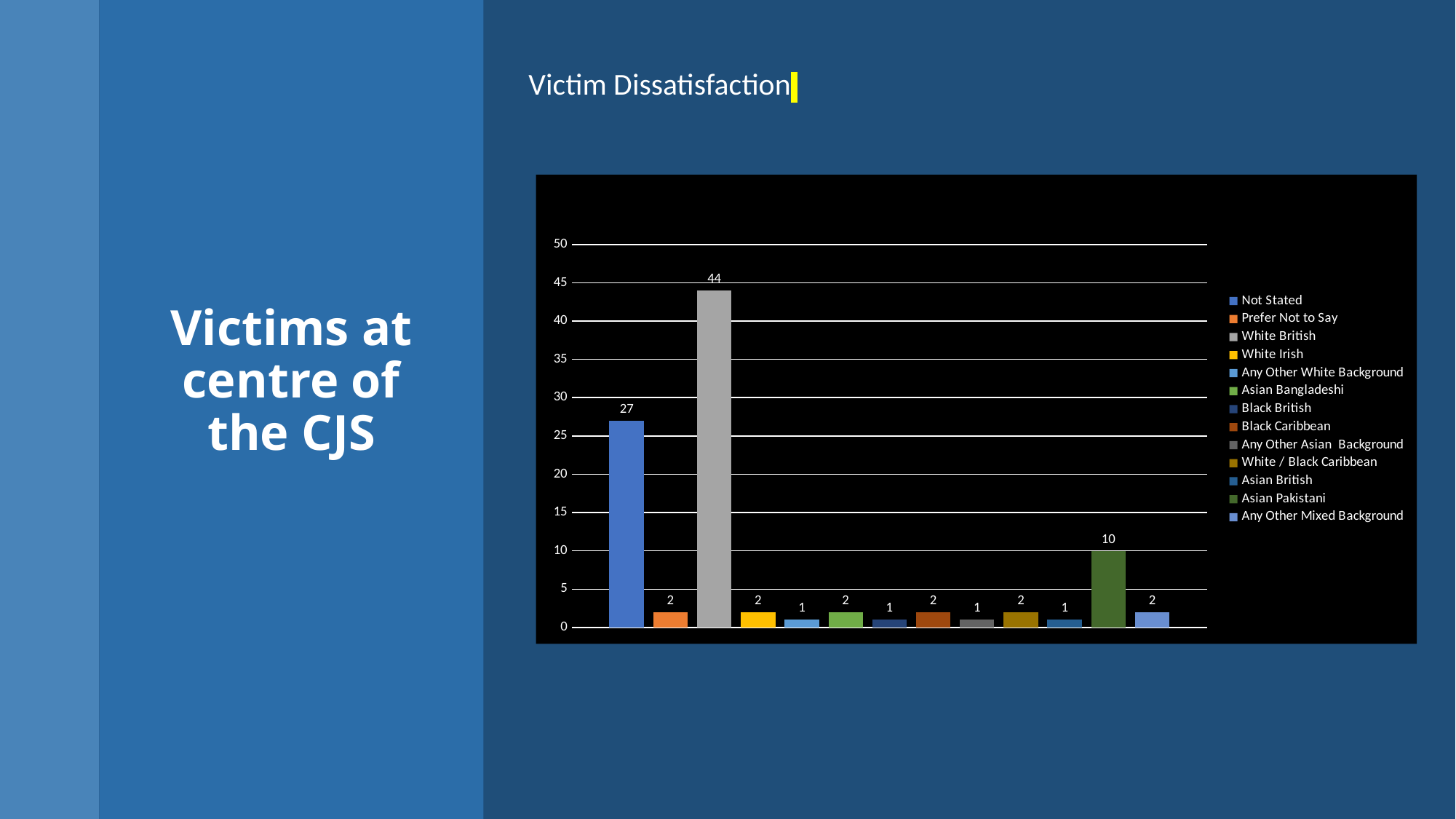
What is the value for Asian Pakistani in the Victim Dissatisfaction chart? 10 What is the value for Not Stated in the Victim Dissatisfaction chart? 27 What is the value for White British in the Victim Dissatisfaction chart? 44 What is the title of the chart on the slide? Victim Dissatisfaction What is the difference between the values for White British and Not Stated in the Victim Dissatisfaction chart? 17 Which is larger in the Victim Dissatisfaction chart, the value for Asian Pakistani or the value for Prefer Not to Say? Asian Pakistani What is the value for Black British in the Victim Dissatisfaction chart? 1 Which category has the highest value in the Victim Dissatisfaction chart? White British What is the difference between the values for Not Stated and Asian Pakistani in the Victim Dissatisfaction chart? 17 What kind of chart is shown on the slide? bar chart How many series does the legend of the Victim Dissatisfaction chart list? 13 Is the value for White British in the Victim Dissatisfaction chart greater or less than 40? greater